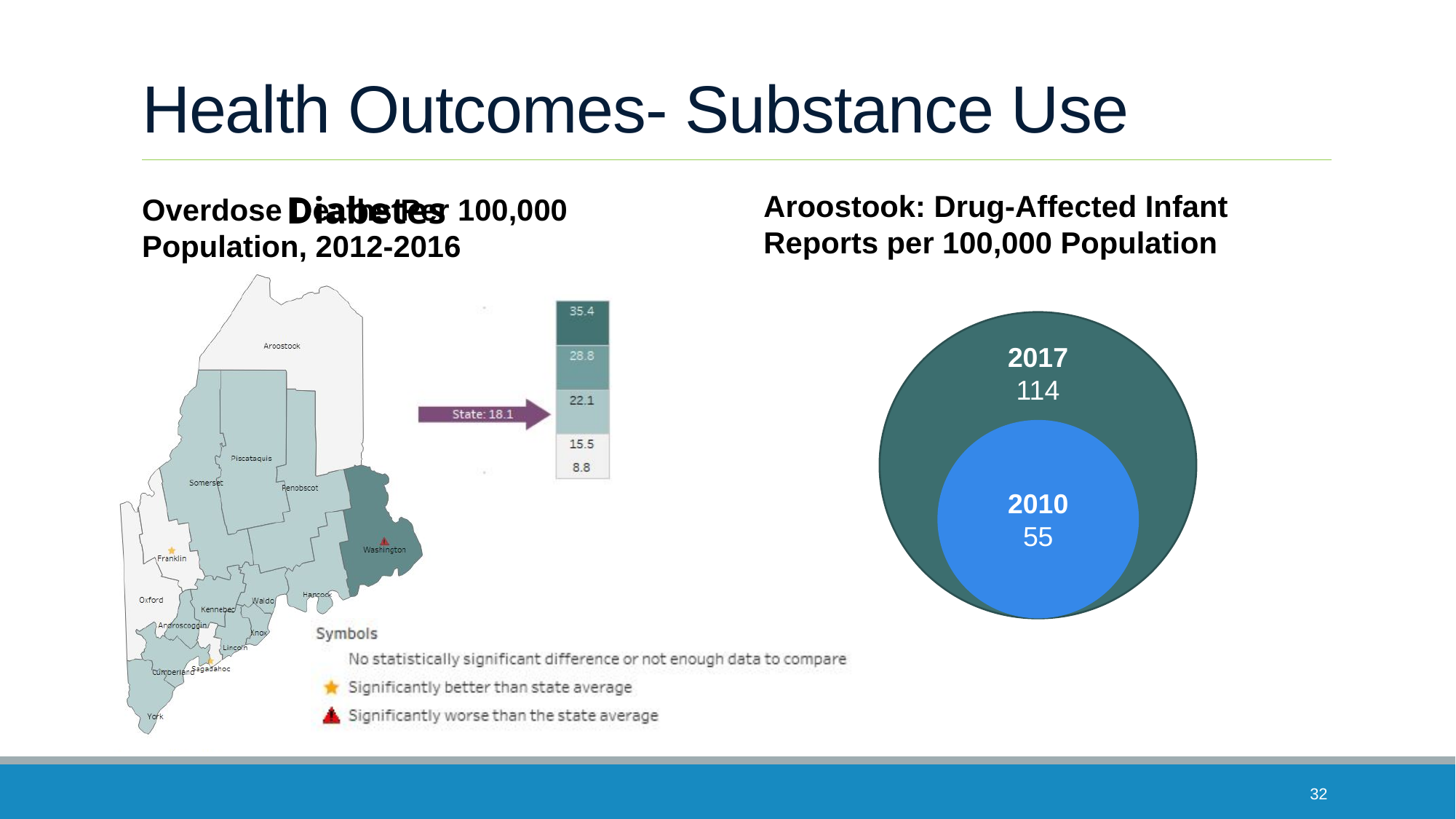
In the Aroostook: Drug-Affected Infant Reports per 100,000 Population chart, what is the value for 2017? 114 In the Aroostook: Drug-Affected Infant Reports per 100,000 Population chart, how many years are shown? 2 In the Aroostook: Drug-Affected Infant Reports per 100,000 Population chart, what is the difference between the 2017 and 2010 values? 59 In the Overdose Deaths per 100,000 Population, 2012-2016 chart, what is the state value shown on the legend scale? 18.1 In the Aroostook: Drug-Affected Infant Reports per 100,000 Population chart, which year has the larger value, 2010 or 2017? 2017 In the Aroostook: Drug-Affected Infant Reports per 100,000 Population chart, did the value rise or fall from 2010 to 2017? rise In the Aroostook: Drug-Affected Infant Reports per 100,000 Population chart, what is the value for 2010? 55 In the Overdose Deaths per 100,000 Population, 2012-2016 map, which county is marked as significantly worse than the state average? Washington In the Overdose Deaths per 100,000 Population, 2012-2016 chart, what is the highest value shown on the legend scale? 35.4 What kind of chart is the Overdose Deaths per 100,000 Population, 2012-2016 chart on the left of the slide? map In the Aroostook: Drug-Affected Infant Reports per 100,000 Population chart, which year has the lowest value? 2010 In the Overdose Deaths per 100,000 Population, 2012-2016 chart, what is the lowest value shown on the legend scale? 8.8